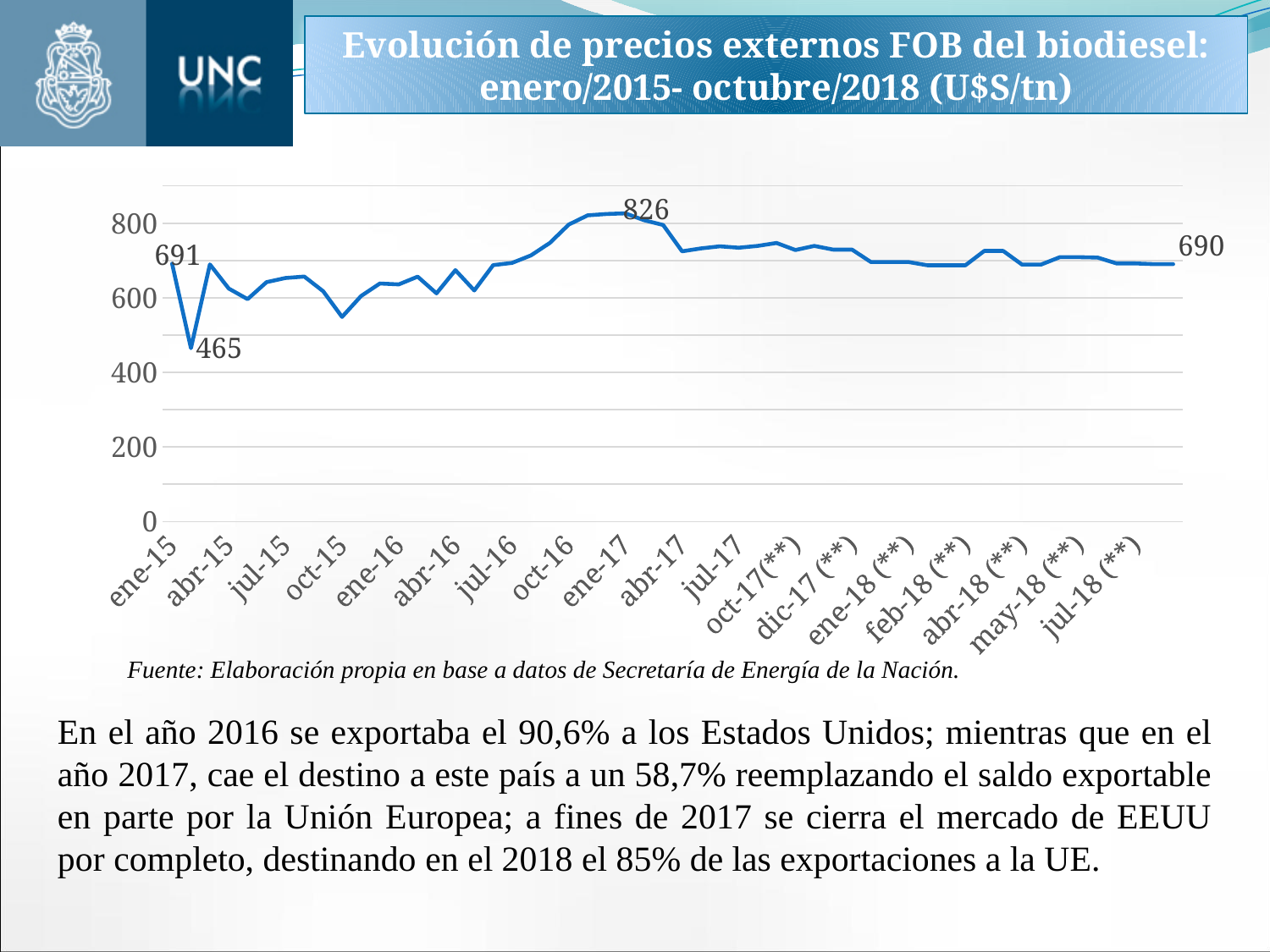
What is the title of the chart? Evolución de precios externos FOB del biodiesel: enero/2015- octubre/2018 (U$S/tn) Is the value around oct-15 greater or less than 600? less What is the lowest value labeled on the line? 465 What is the biodiesel FOB price shown for ene-15? 691 What is the highest value labeled on the line? 826 What kind of chart is shown on the slide? Line chart What value is labeled at the last point of the line (right end)? 690 What is the highest tick value shown on the y axis? 800 What is the difference between the peak value (826) and the lowest value (465)? 361 Is the value at jul-17 greater or less than 800? less What is the difference between the first labeled value (691) and the last labeled value (690)? 1 Does the line rise or fall between ene-17 and abr-17? fall